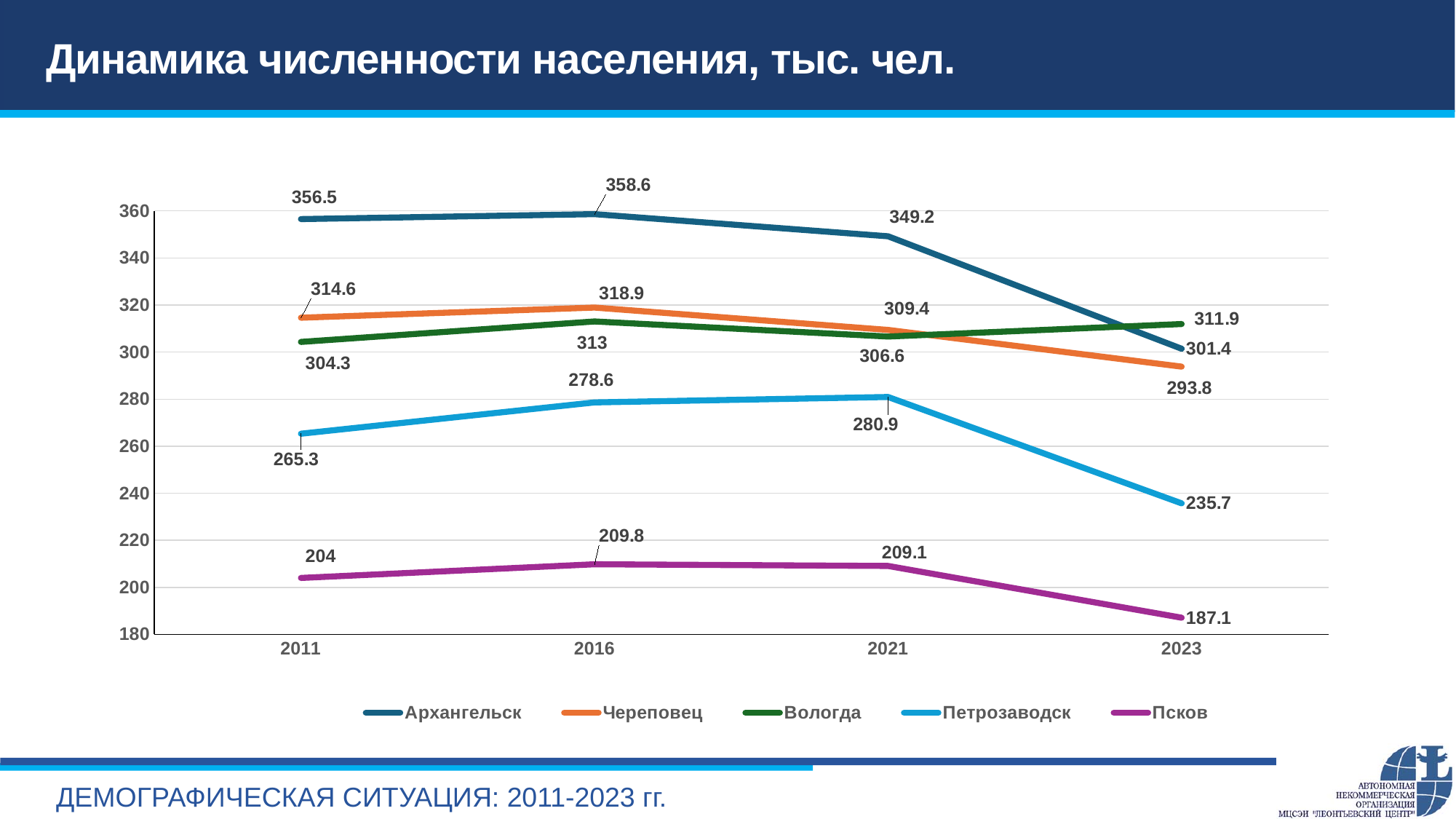
Which city has the lowest value in 2023? Псков What is the difference between the Архангельск values in 2021 and 2023? 47.8 Does the value for Петрозаводск rise or fall from 2021 to 2023? fall What is the title of the chart? Динамика численности населения, тыс. чел. What is the value for Петрозаводск in 2023? 235.7 How many series does the legend list? 5 What type of chart is shown on the slide? line chart How many points on the x axis does the chart show? 4 Which is larger in 2023, the value for Вологда or the value for Череповец? Вологда What is the value for Архангельск in 2016? 358.6 Which city has the highest value in 2011? Архангельск What is the value for Псков in 2011? 204